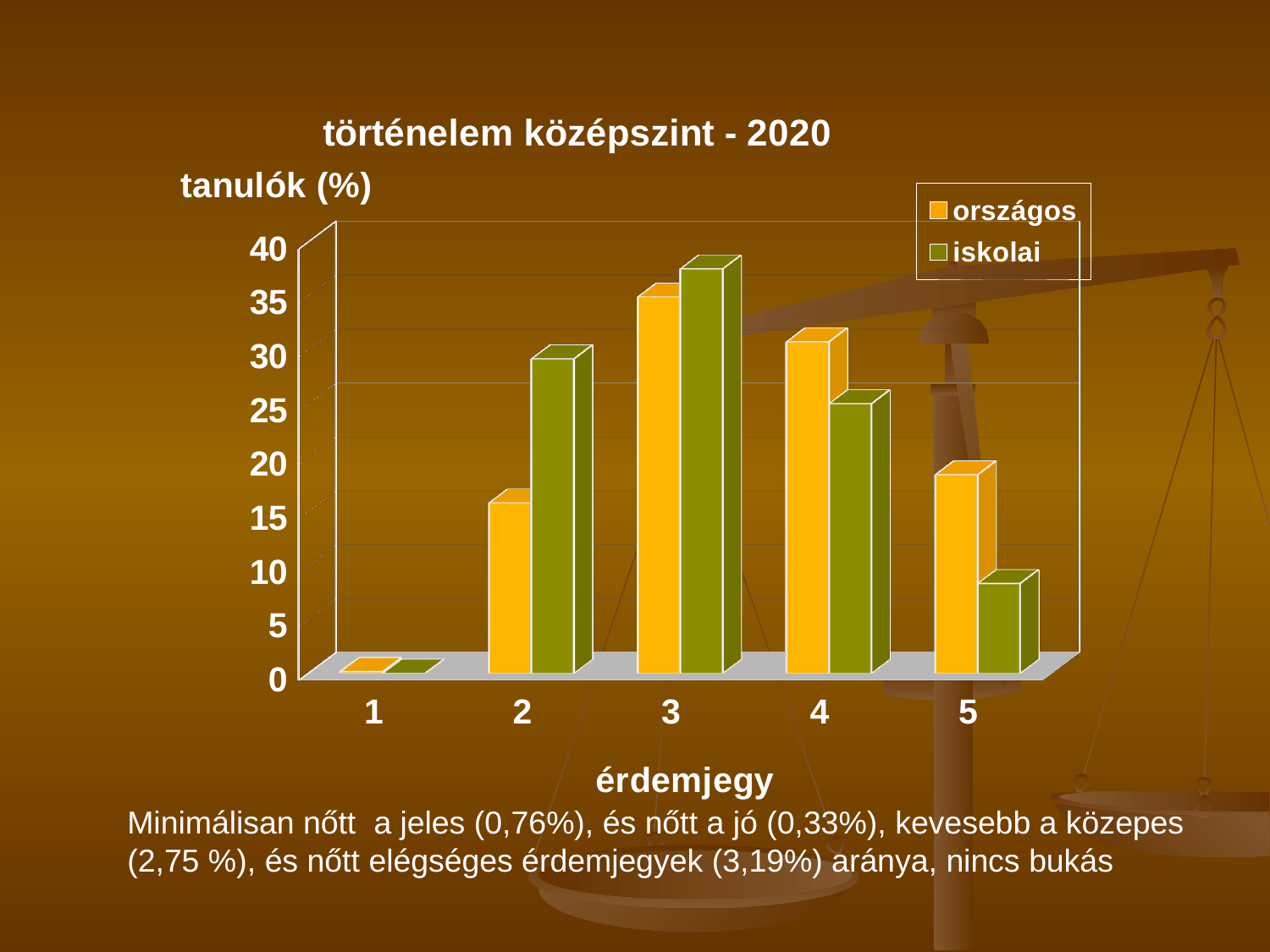
For érdemjegy 2, which series has the larger value, országos or iskolai? iskolai What is the title of the chart? történelem középszint - 2020 For which érdemjegy is the országos value highest? 3 Is the iskolai value for érdemjegy 2 greater or less than 25? greater How many érdemjegy categories are shown on the x axis? 5 What kind of chart is shown on the slide? bar chart How many series does the legend list? 2 For which érdemjegy is the iskolai value lowest? 1 Is the iskolai value for érdemjegy 5 greater or less than 10? less For which érdemjegy is the iskolai value highest? 3 For érdemjegy 5, which series has the larger value, országos or iskolai? országos Is the országos value for érdemjegy 4 greater or less than 25? greater